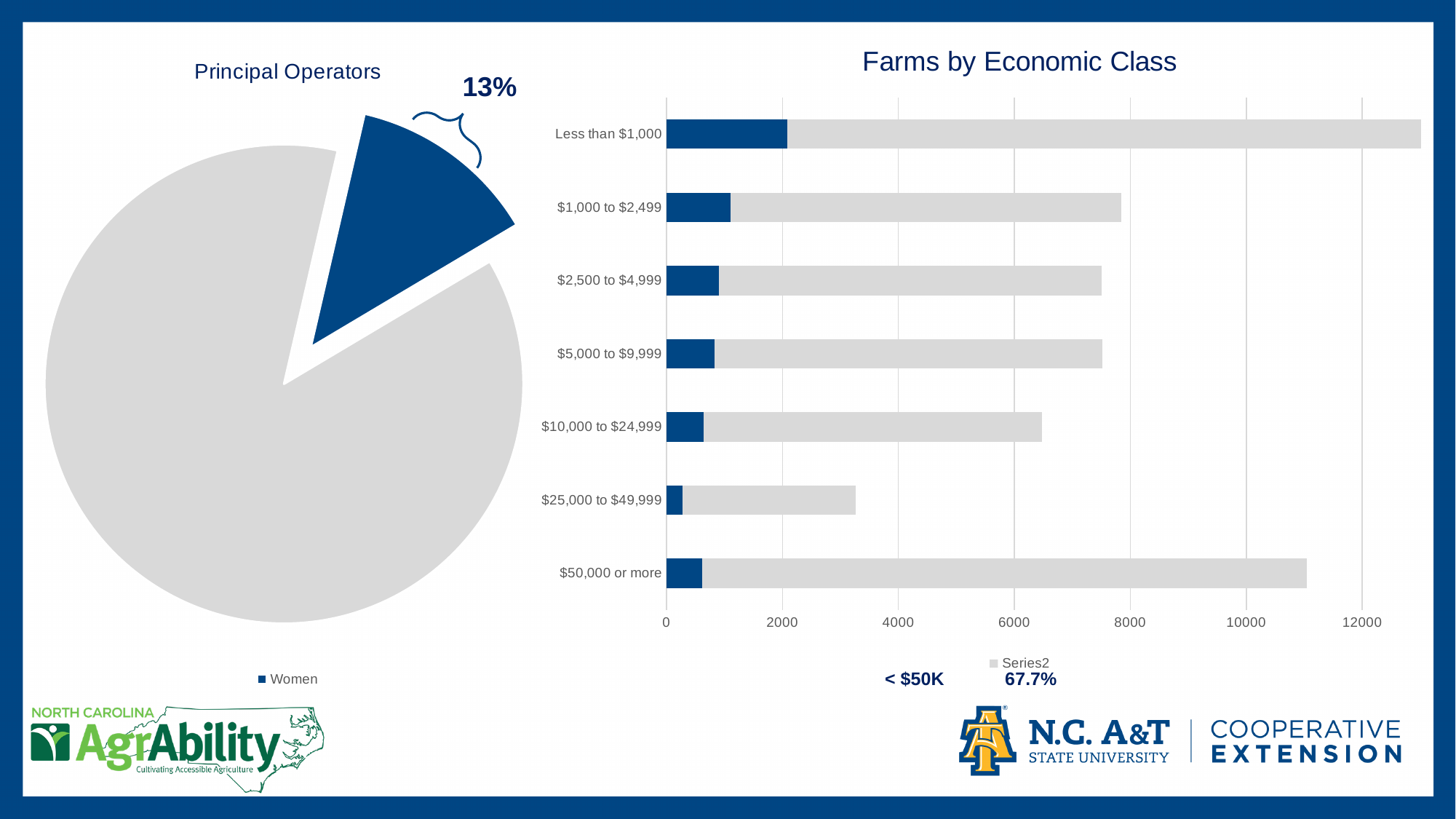
In the 'Farms by Economic Class' chart, which economic class has the shortest total bar? $25,000 to $49,999 In the 'Farms by Economic Class' chart, is the total bar for '$25,000 to $49,999' greater or less than 4000? less In the 'Farms by Economic Class' chart, is the total bar for 'Less than $1,000' greater or less than 12000? greater In the 'Farms by Economic Class' chart, is the total bar for '$50,000 or more' greater or less than 10000? greater How many economic class categories are shown in the 'Farms by Economic Class' chart? 7 What type of chart is the 'Principal Operators' chart on the left? pie chart In the 'Principal Operators' pie chart, what is the only entry listed in the legend? Women What type of chart is the 'Farms by Economic Class' chart on the right? bar chart In the 'Farms by Economic Class' chart, which has the longer total bar: '$50,000 or more' or '$1,000 to $2,499'? $50,000 or more In the 'Principal Operators' pie chart, what share of the pie is the Women slice? 13% What is the title of the bar chart on the right side of the slide? Farms by Economic Class In the 'Farms by Economic Class' chart, which economic class has the longest total bar? Less than $1,000